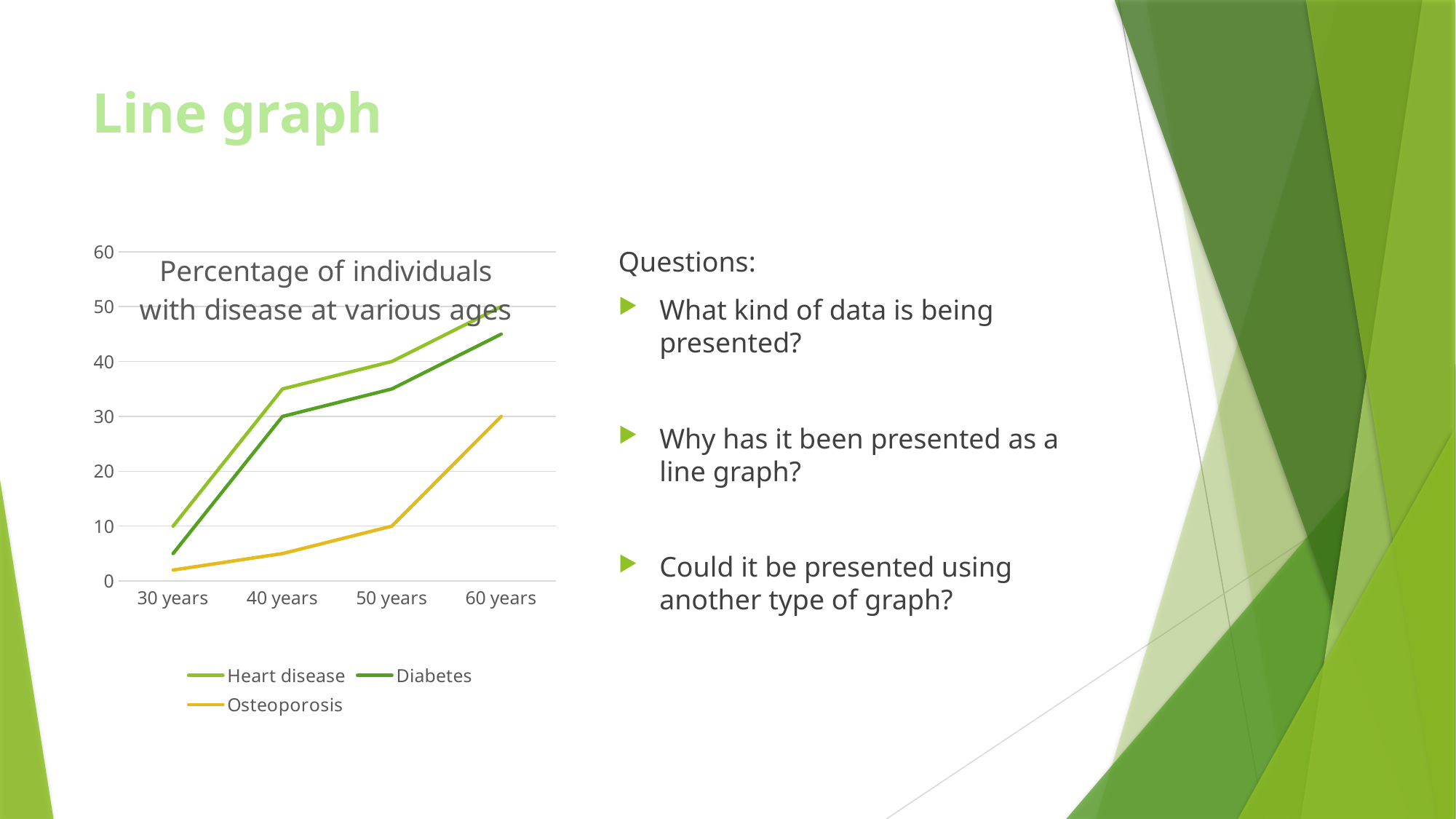
Is the value for Diabetes at 60 years greater or less than 40? greater What is the title of the chart? Percentage of individuals with disease at various ages What is the value for Heart disease at 50 years? 40 Which series has the highest value at 40 years? Heart disease How many series does the legend list? 3 What is the value for Osteoporosis at 60 years? 30 Does the Heart disease line rise or fall from 30 years to 60 years? rise Is the value for Osteoporosis at 40 years greater or less than 10? less How many age categories are shown on the x axis? 4 Which series has the lowest value at 60 years? Osteoporosis What type of chart is shown on the slide? line chart Which is larger at 50 years, Diabetes or Osteoporosis? Diabetes